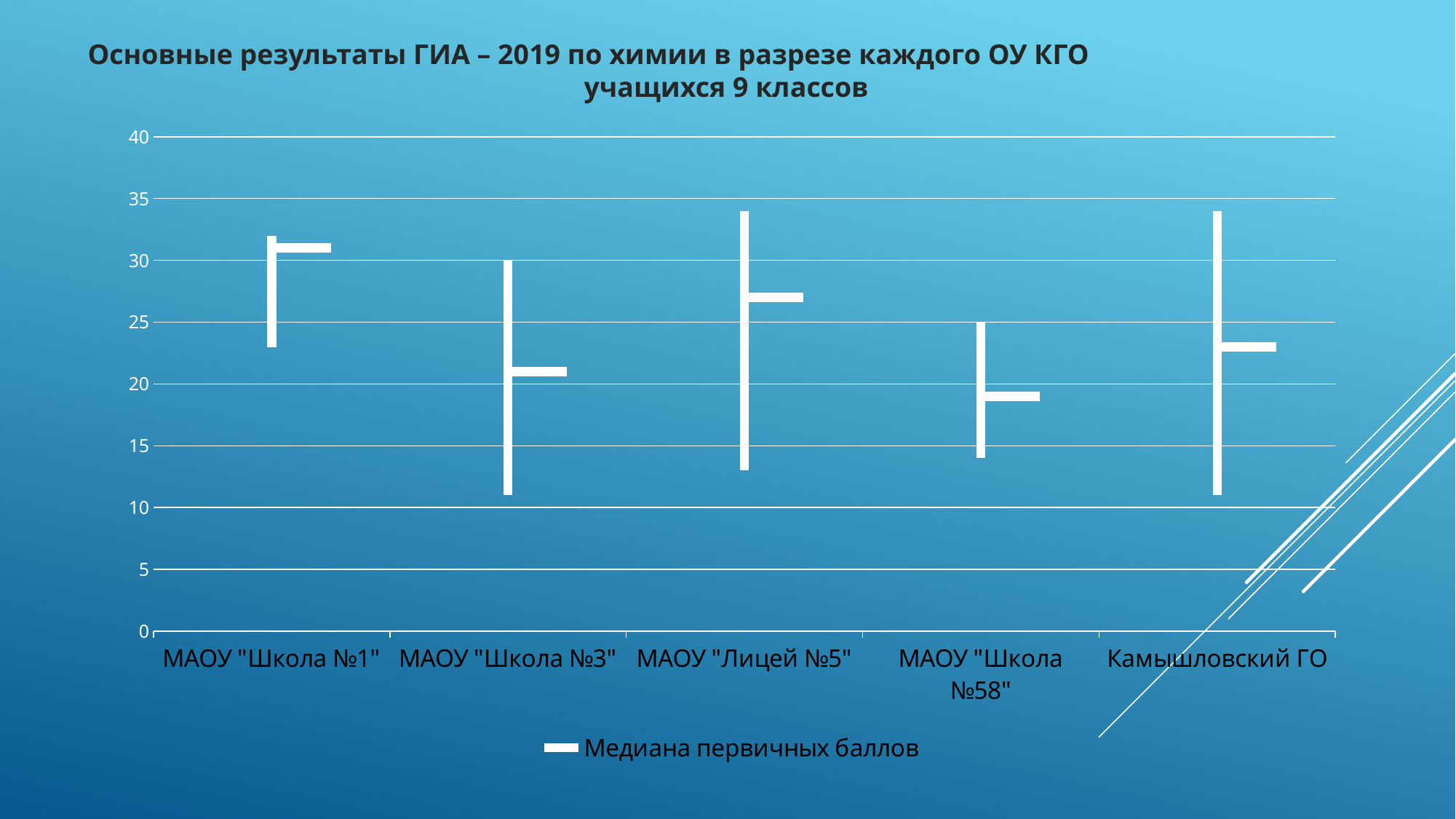
How many series does the chart legend list? 1 Is the median of primary scores for МАОУ "Лицей №5" greater or less than 30? less Which institution has the highest median of primary scores (Медиана первичных баллов)? МАОУ "Школа №1" Is the median of primary scores for МАОУ "Школа №58" greater or less than 25? less Is the median of primary scores for МАОУ "Школа №1" greater or less than 25? greater What is the title of the chart? Основные результаты ГИА – 2019 по химии в разрезе каждого ОУ КГО учащихся 9 классов What is the name of the series shown in the chart legend? Медиана первичных баллов Which has a larger median of primary scores: МАОУ "Лицей №5" or Камышловский ГО? МАОУ "Лицей №5" Which has a larger median of primary scores: МАОУ "Школа №1" or МАОУ "Лицей №5"? МАОУ "Школа №1" How many educational institutions (categories) are shown on the x axis of the chart? 5 Which institution has the lowest median of primary scores (Медиана первичных баллов)? МАОУ "Школа №58"